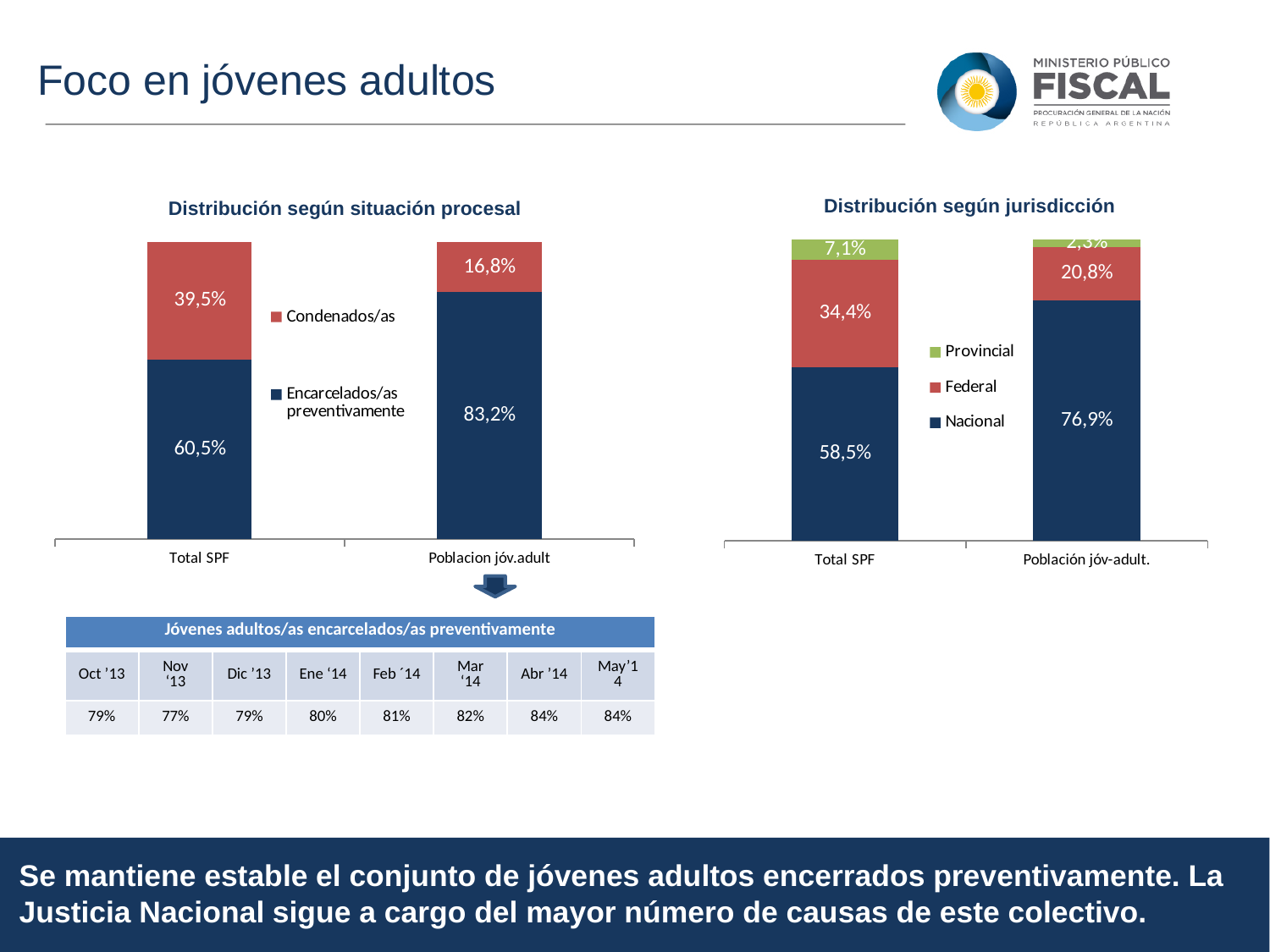
In the chart 'Distribución según situación procesal', what is the difference between the Condenados/as values for Total SPF and Poblacion jóv.adult? 22,7% In the chart 'Distribución según jurisdicción', what is the value for Provincial for Total SPF? 7,1% In the chart 'Distribución según jurisdicción', how many series does the legend list? 3 In the chart 'Distribución según jurisdicción', which category has the higher Nacional value? Población jóv-adult. In the chart 'Distribución según situación procesal', what is the value for Condenados/as for Poblacion jóv.adult? 16,8% In the chart 'Distribución según jurisdicción', what is the value for Nacional for Total SPF? 58,5% In the chart 'Distribución según situación procesal', how many series does the legend list? 2 What kind of chart is 'Distribución según jurisdicción'? Stacked bar chart In the chart 'Distribución según jurisdicción', what is the value for Federal for Población jóv-adult.? 20,8% In the chart 'Distribución según situación procesal', what is the value for Encarcelados/as preventivamente for Poblacion jóv.adult? 83,2% In the chart 'Distribución según situación procesal', what is the value for Encarcelados/as preventivamente for Total SPF? 60,5% In the chart 'Distribución según situación procesal', how many categories are shown on the x axis? 2